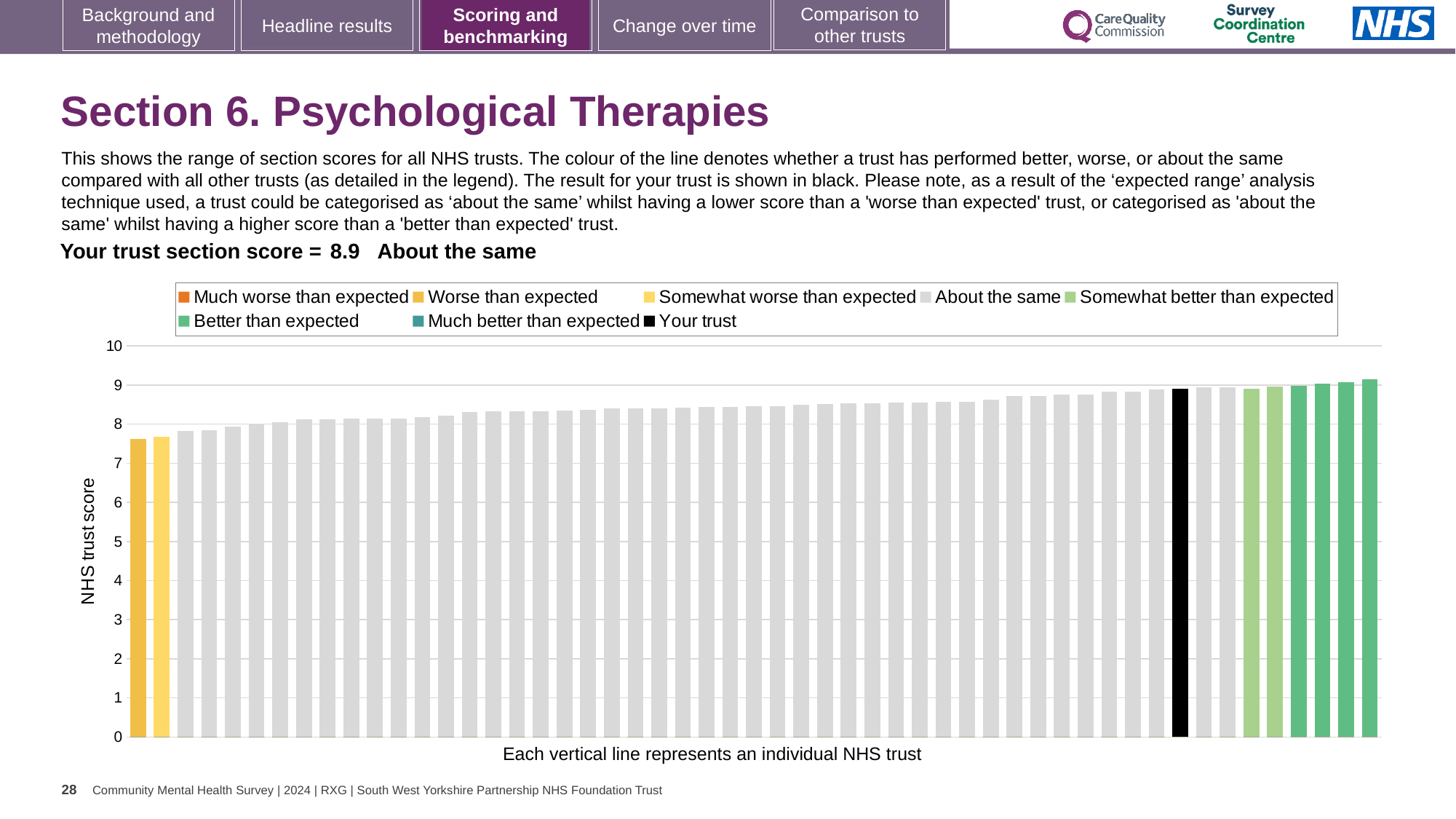
What is the section score for your trust shown on the slide? 8.9 How many bars are coloured as 'Better than expected' (dark green)? 4 How many entries does the chart legend list? 8 Is the value of the black bar (your trust) greater or less than 8? greater How is your trust's section score categorised compared with other trusts? About the same Is the value of the leftmost bar greater or less than 8? less Is the value of the rightmost bar greater or less than 9? greater What colour is the bar representing your trust? black Do the bar values rise or fall from left to right along the x axis? rise What is the highest value shown on the vertical axis? 10 What is the label on the vertical axis of the chart? NHS trust score What kind of chart is shown on the slide? bar chart